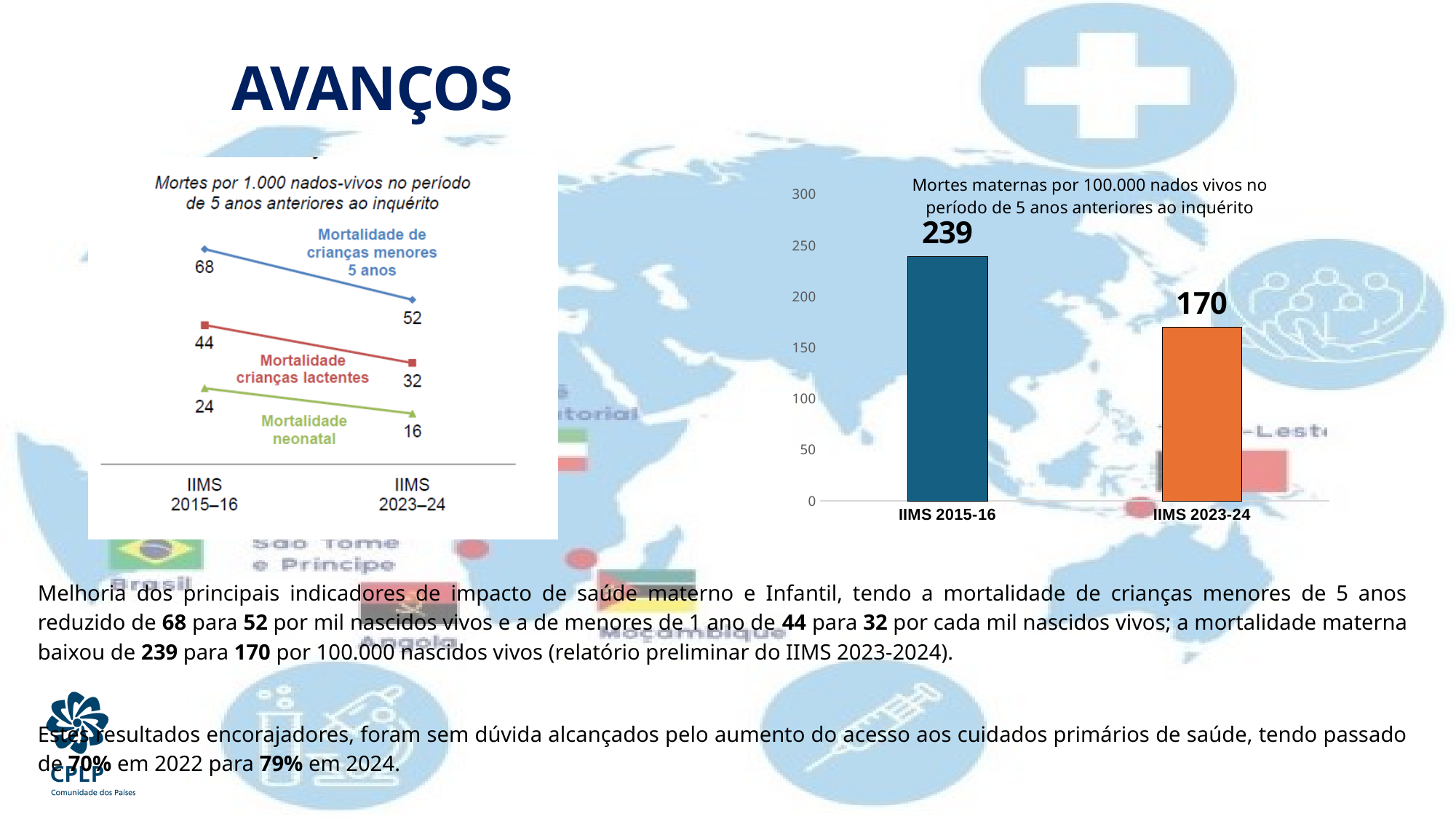
In the bar chart on the right (maternal deaths per 100,000 live births), what is the value for IIMS 2015-16? 239 In the bar chart on the right, which survey period has the higher maternal mortality value? IIMS 2015-16 In the line chart on the left, do the values rise or fall from IIMS 2015–16 to IIMS 2023–24? fall How many bars are plotted in the bar chart on the right? 2 In the line chart on the left, what is the value for 'Mortalidade crianças lactentes' at IIMS 2023–24? 32 In the line chart on the left, by how much did 'Mortalidade de crianças menores 5 anos' change between IIMS 2015–16 and IIMS 2023–24? 16 In the line chart on the left, what is the value for 'Mortalidade neonatal' at IIMS 2015–16? 24 What kind of chart is the one on the right showing maternal deaths per 100,000 live births? bar chart In the line chart on the left, which series has the lowest value at IIMS 2023–24? Mortalidade neonatal In the line chart on the left, what is the value for 'Mortalidade de crianças menores 5 anos' at IIMS 2015–16? 68 In the bar chart on the right (maternal deaths per 100,000 live births), what is the value for IIMS 2023-24? 170 In the bar chart on the right, by how much did maternal mortality fall from IIMS 2015-16 to IIMS 2023-24? 69